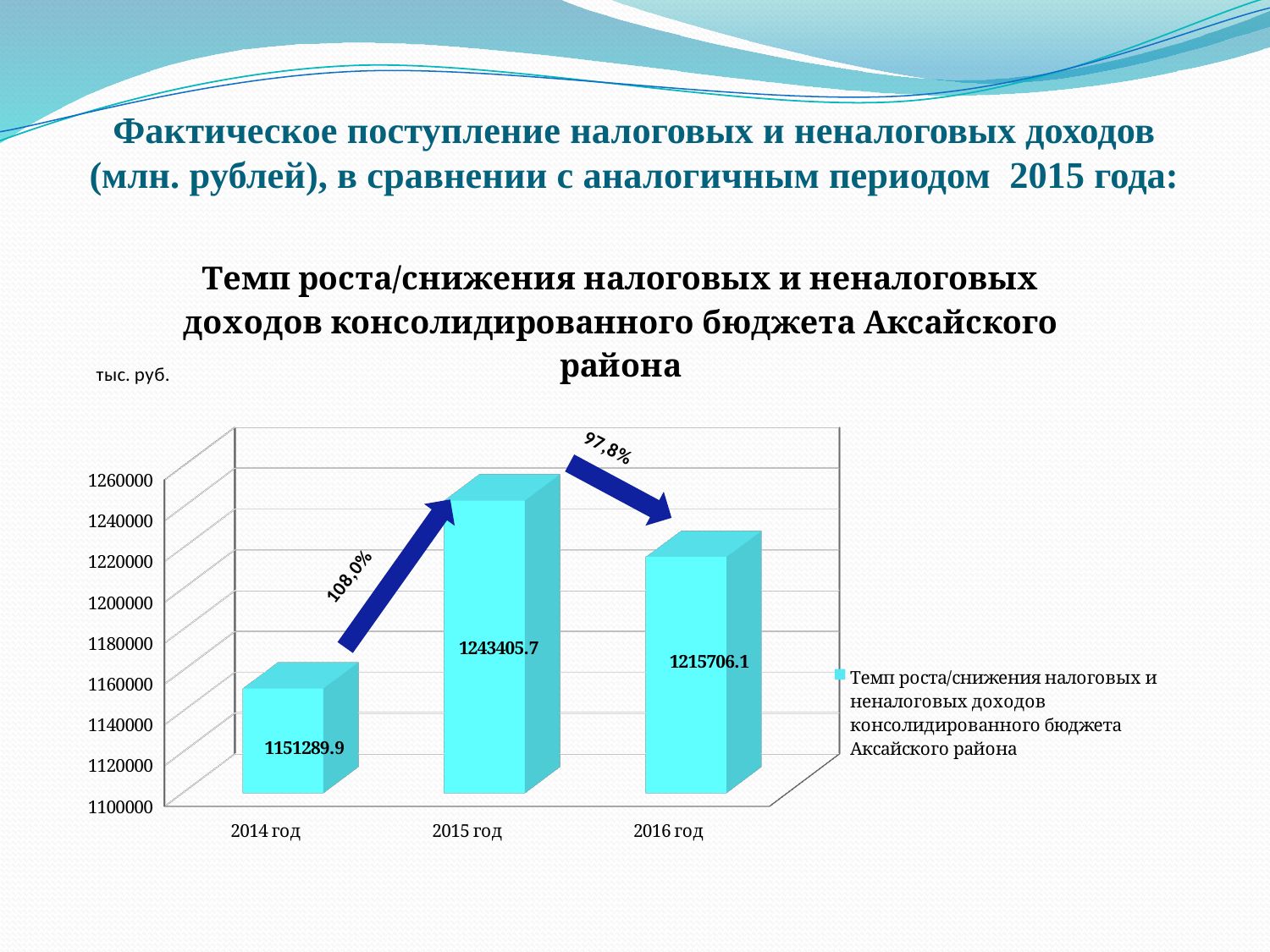
Which year has the highest value? 2015 год What is the difference between the values for 2015 год and 2014 год? 92115.8 What kind of chart is shown on the slide? bar chart What is the difference between the values for 2015 год and 2016 год? 27699.6 How many years are shown on the x axis? 3 What is the value for 2015 год? 1243405.7 Which year has the lowest value? 2014 год What is the value for 2014 год? 1151289.9 Is the value for 2014 год greater or less than 1160000? less Which is larger, the value for 2016 год or the value for 2014 год? 2016 год What growth rate is shown on the arrow between 2014 год and 2015 год? 108,0% What is the value for 2016 год? 1215706.1